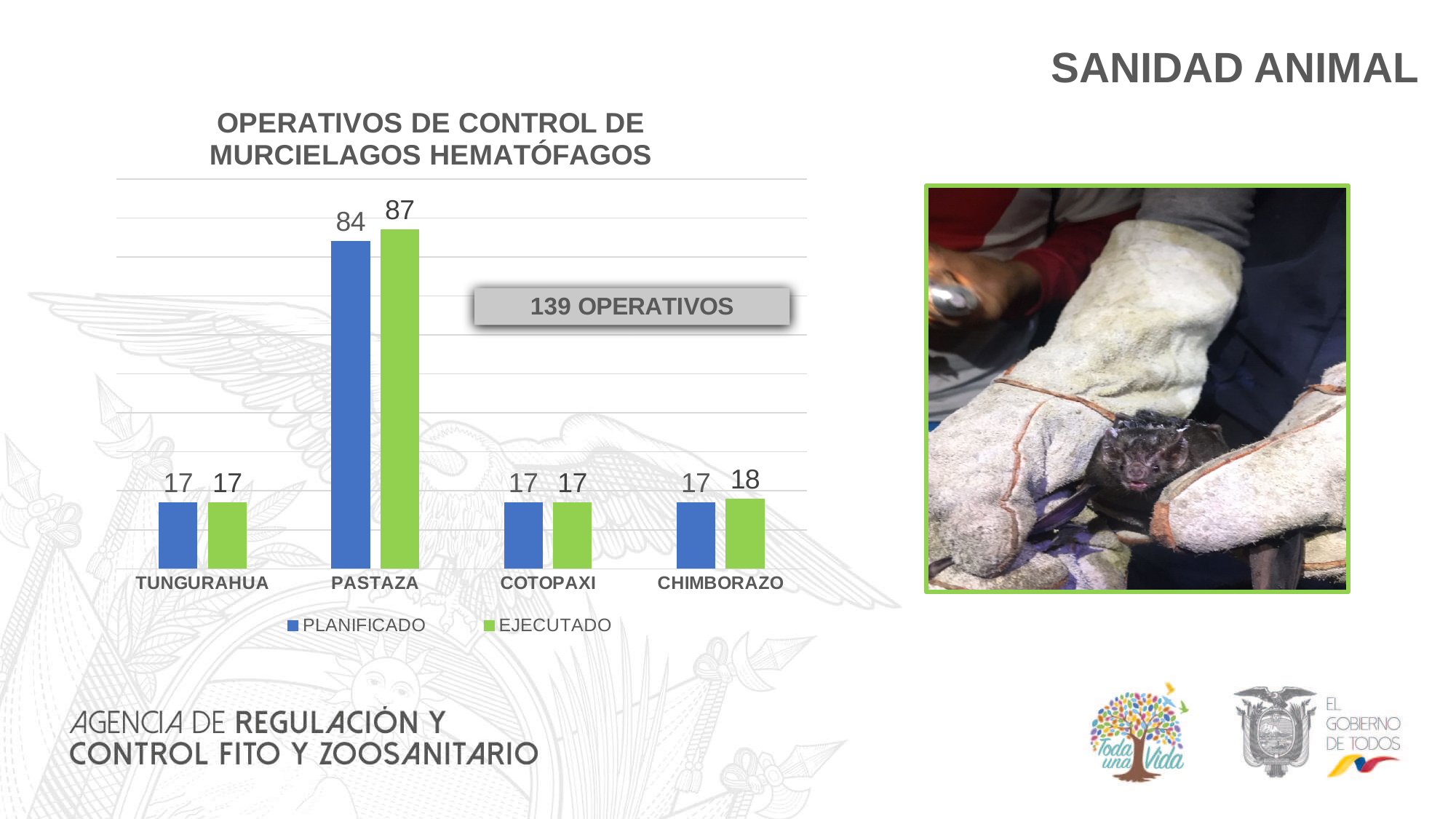
Which is larger: the EJECUTADO value for PASTAZA or the PLANIFICADO value for PASTAZA? EJECUTADO value for PASTAZA What is the EJECUTADO value for CHIMBORAZO? 18 What is the title of the chart? OPERATIVOS DE CONTROL DE MURCIELAGOS HEMATÓFAGOS What is the difference between the EJECUTADO and PLANIFICADO values for PASTAZA? 3 What is the EJECUTADO value for PASTAZA? 87 What is the PLANIFICADO value for PASTAZA? 84 What kind of chart is shown on the slide? bar chart Which category has the highest EJECUTADO value? PASTAZA How many series does the legend list? 2 Which colour represents the EJECUTADO series? green How many categories are shown on the x axis? 4 What is the difference between the PLANIFICADO values for PASTAZA and COTOPAXI? 67